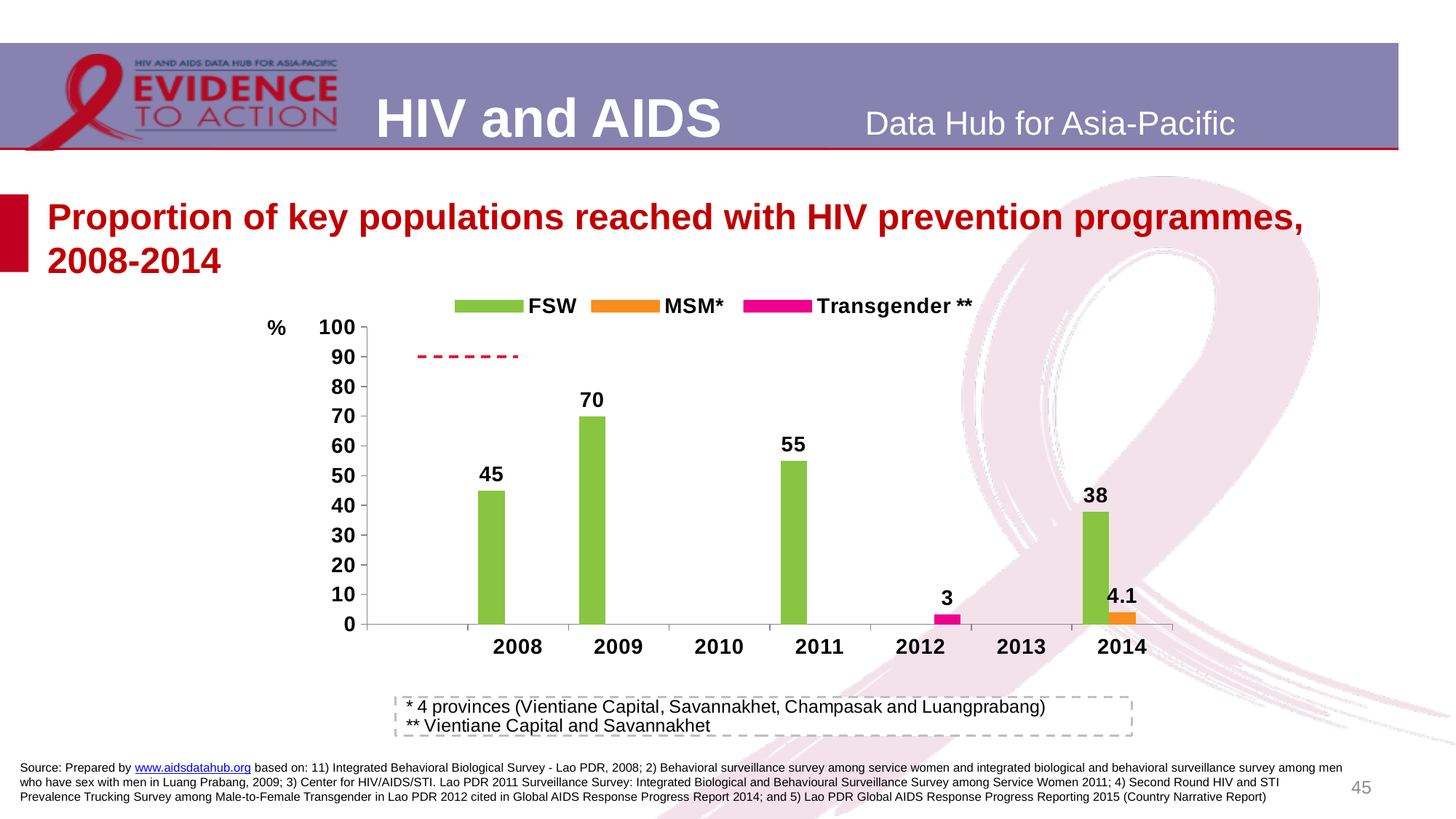
What is the value for FSW in 2008? 45 What kind of chart is shown on the slide? Bar chart What is the value for MSM* in 2014? 4.1 In which year is the FSW value lowest? 2014 How many series does the legend list? 3 In which year is the FSW value highest? 2009 Which is larger in 2014, the FSW value or the MSM* value? FSW What is the difference between the FSW values in 2009 and 2011? 15 How many years are shown on the x axis? 7 What is the value for FSW in 2009? 70 What is the value for FSW in 2014? 38 What is the value for Transgender ** in 2012? 3